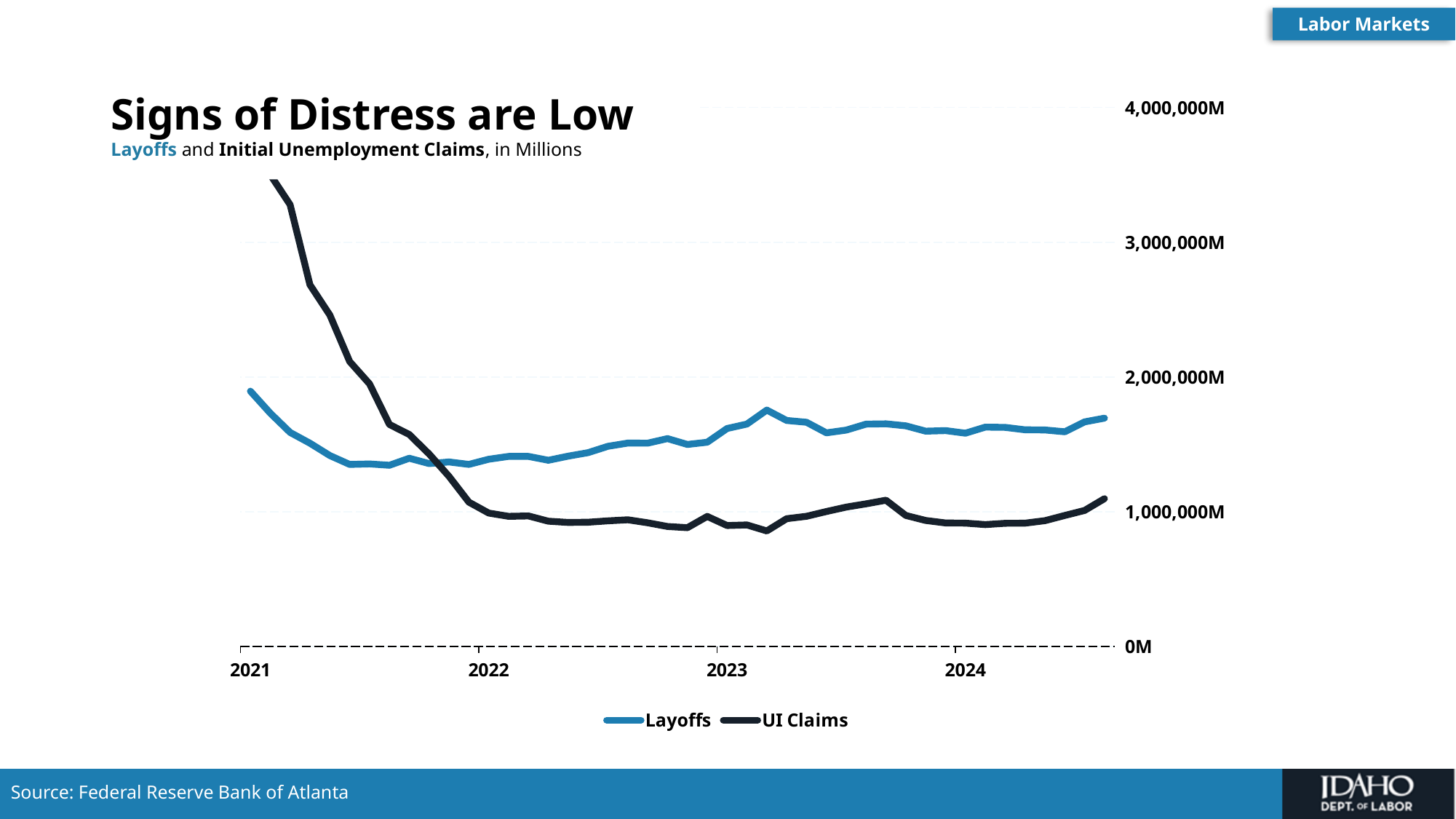
How many year labels are shown on the x axis? 4 What is the title of the chart? Signs of Distress are Low Is the value for UI Claims at the start of 2024 greater or less than 1,000,000M? less Does the UI Claims line rise or fall between 2021 and 2022? fall What kind of chart is shown on the slide? line chart At the start of 2021, which series has the higher value, Layoffs or UI Claims? UI Claims At the start of 2023, which series has the higher value, Layoffs or UI Claims? Layoffs Is the value for UI Claims at the start of 2021 greater or less than 3,000,000M? greater What are the two series named in the legend? Layoffs and UI Claims How many series does the legend list? 2 Is the value for Layoffs at the start of 2021 greater or less than 2,000,000M? less